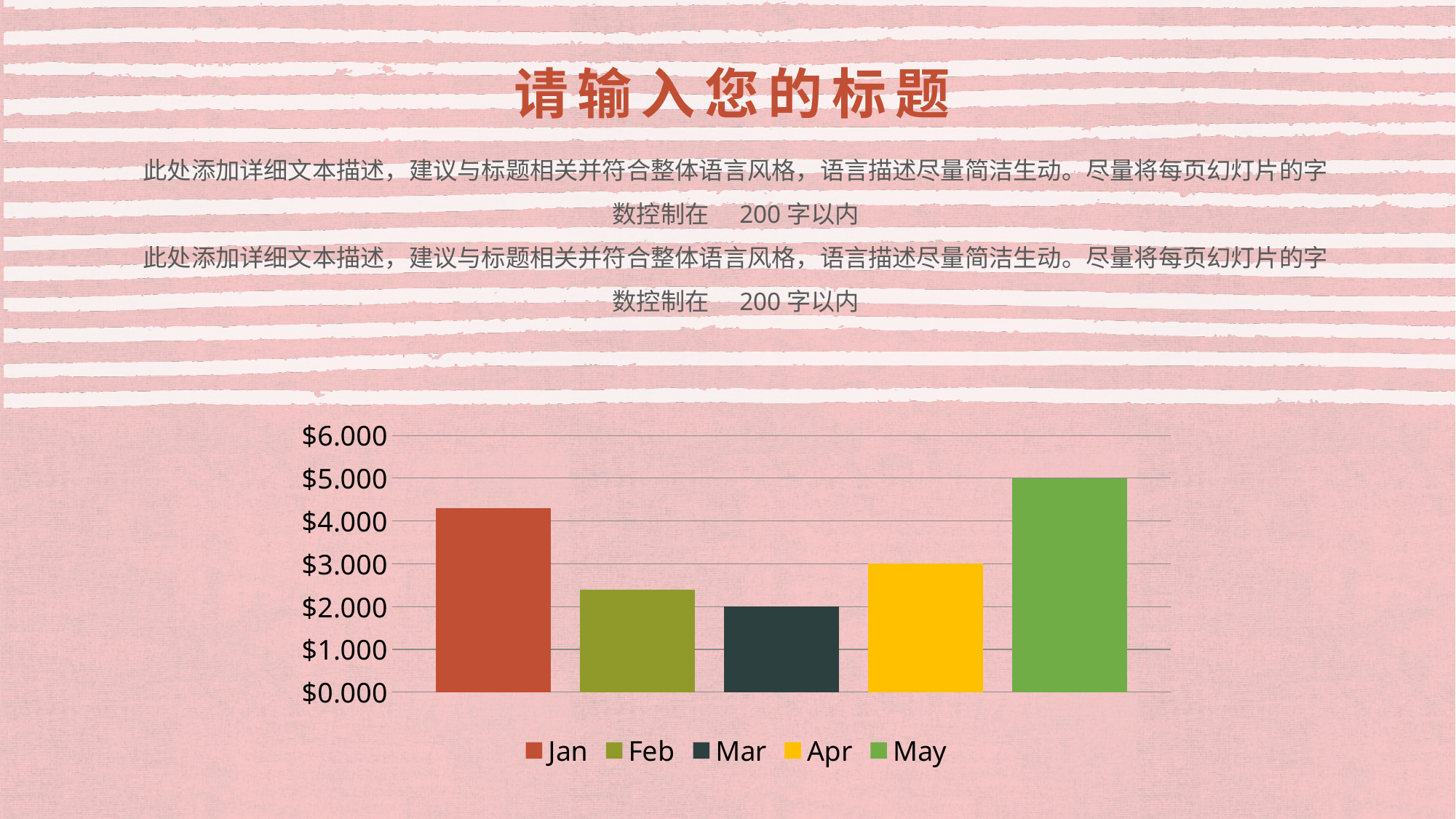
What is the value for May in the chart? $5.000 Which is larger, the value for Jan or the value for Feb? Jan How many bars are plotted in the chart? 5 What is the difference between the values for May and Apr? $2.000 How many entries does the chart's legend list? 5 Is the value for Feb greater or less than $3.000? less What is the value for Apr in the chart? $3.000 Which month has the highest bar in the chart? May Is the value for Jan greater or less than $4.000? greater Which month has the lowest bar in the chart? Mar What is the value for Mar in the chart? $2.000 What kind of chart is shown on the slide? bar chart